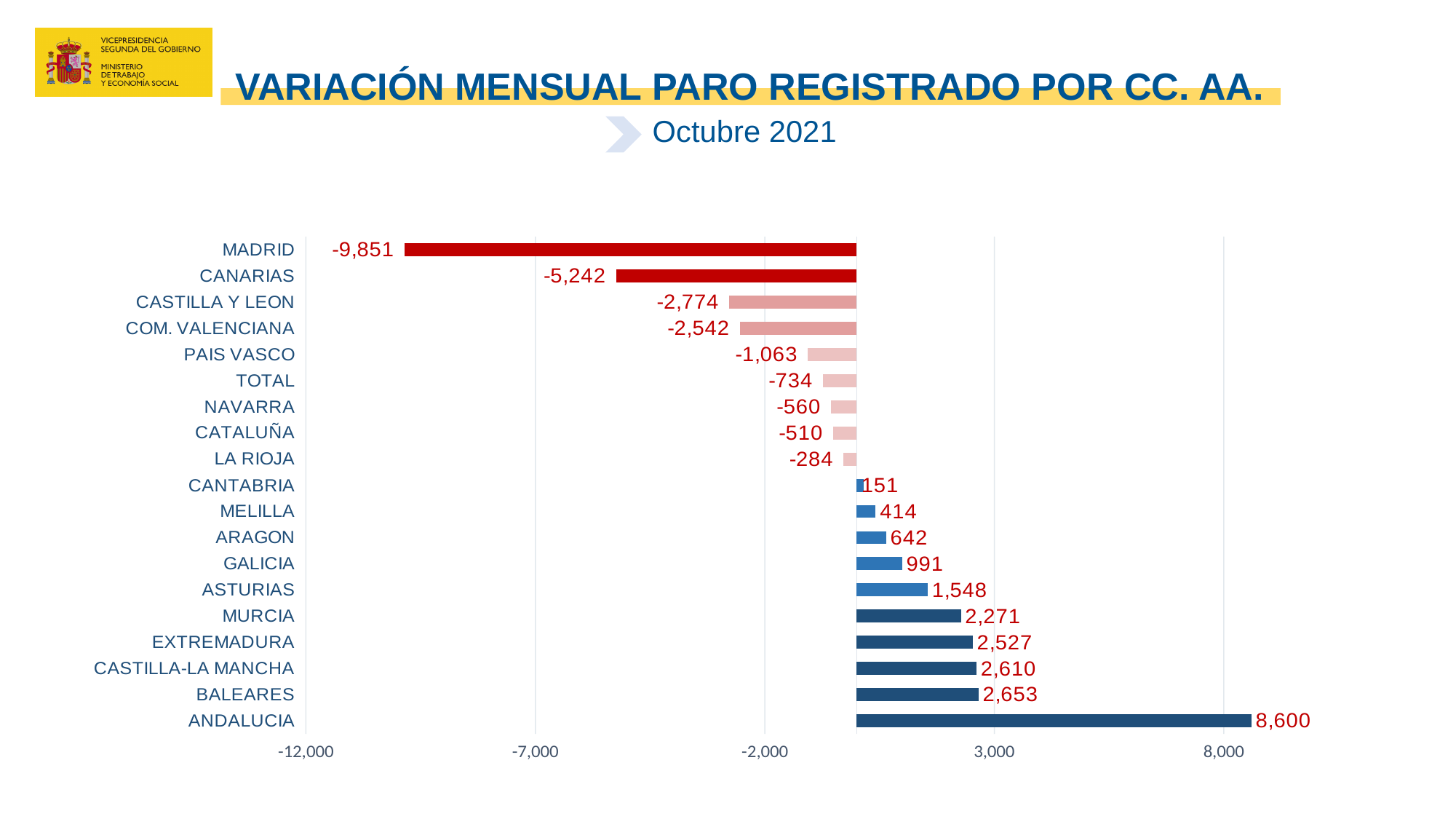
What is the difference between the values for BALEARES and CASTILLA-LA MANCHA? 43 What is the value for TOTAL? -734 What is the value for ANDALUCIA? 8,600 Which is larger, the value for MURCIA or the value for EXTREMADURA? EXTREMADURA Which category has the lowest value? MADRID What is the value for GALICIA? 991 What is the value for MADRID? -9,851 Is the value for CANARIAS greater or less than -2,000? less How many categories are shown on the chart? 19 What kind of chart is shown on the slide? bar chart What month and year does the chart subtitle refer to? Octubre 2021 Which category has the highest value? ANDALUCIA